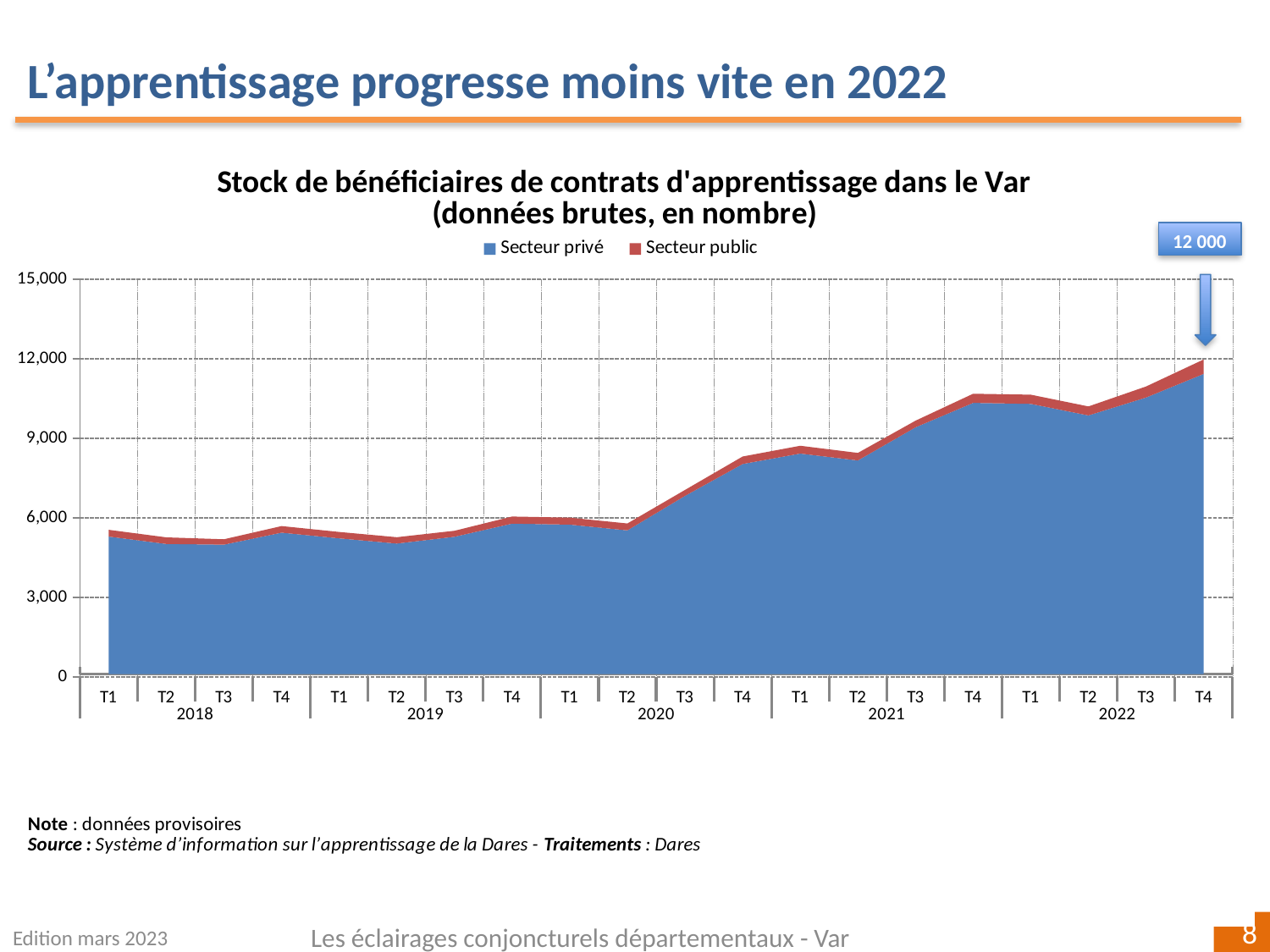
Is the total value for T4 2022 greater or less than 9,000? greater Is the total value for T4 2020 greater or less than 6,000? greater How many series does the chart legend list? 2 Overall, does the total stock of apprenticeship beneficiaries rise or fall from T1 2018 to T4 2022? Rise Which two series are listed in the chart legend? Secteur privé and Secteur public Which quarter has the highest total stock of apprenticeship beneficiaries? T4 2022 Is the total value for T4 2021 greater or less than 9,000? greater What value does the callout box above the chart indicate for T4 2022? 12 000 How many quarterly points are plotted along the x axis? 20 Which series accounts for the larger share of the stock, Secteur privé or Secteur public? Secteur privé What kind of chart is shown on the slide? Stacked area chart